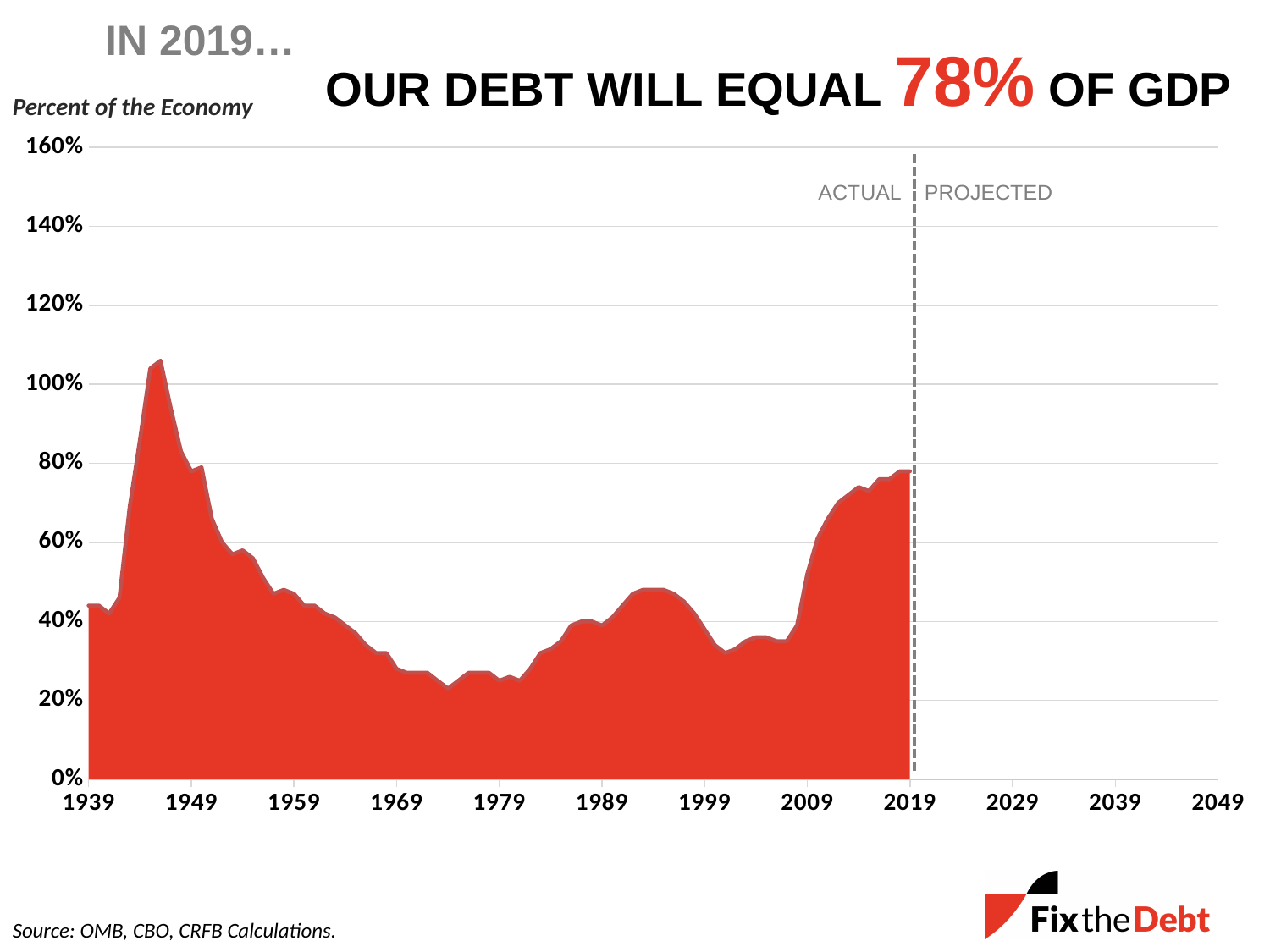
Which is larger, the value for 1939 or the value for 1969? 1939 Is the value for 1939 greater or less than 60%? less Which is larger, the value for 2019 or the value for 1999? 2019 Is the peak value of the chart greater or less than 100%? greater According to the slide, what will debt equal as a percent of GDP in 2019? 78% Is the value for 1969 greater or less than 40%? less In which decade does the chart reach its highest value? 1940s What two periods does the dashed vertical line at 2019 separate? Actual and Projected Do the values rise or fall between 2009 and 2019? rise What kind of chart is shown on the slide? Area chart What is the label on the vertical axis of the chart? Percent of the Economy